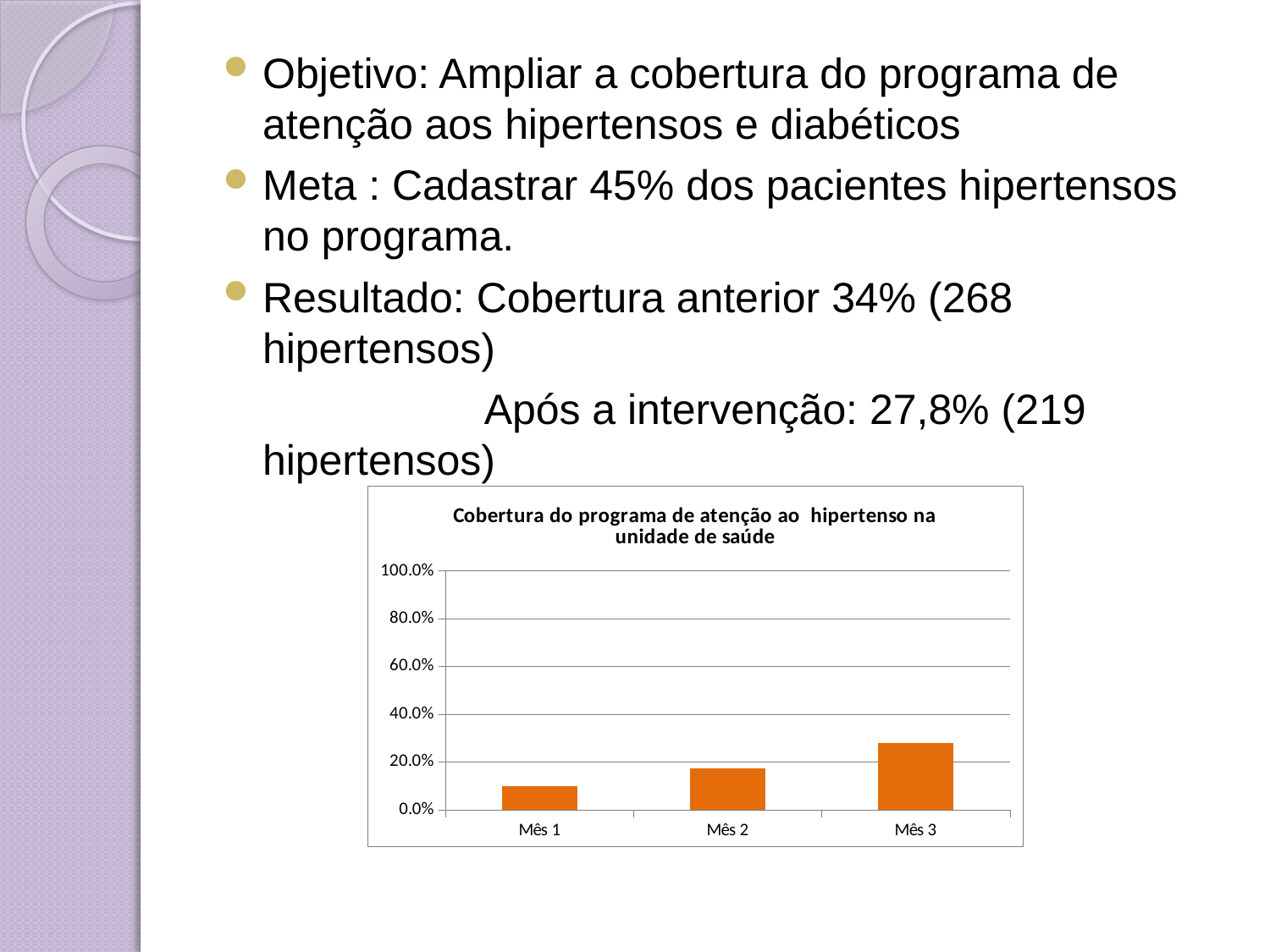
What kind of chart is shown on the slide? bar chart What is the title of the chart? Cobertura do programa de atenção ao hipertenso na unidade de saúde Is the value for Mês 3 greater or less than 40.0%? less Which is larger, the value for Mês 1 or the value for Mês 3? Mês 3 How many categories are shown on the x axis of the chart? 3 Do the values rise or fall from Mês 1 to Mês 3? rise What is the highest value shown on the y axis of the chart? 100.0% Which month has the lowest bar in the chart? Mês 1 Which month has the highest bar in the chart? Mês 3 Is the value for Mês 1 greater or less than 20.0%? less Which is larger, the value for Mês 2 or the value for Mês 1? Mês 2 Is the value for Mês 3 greater or less than 20.0%? greater